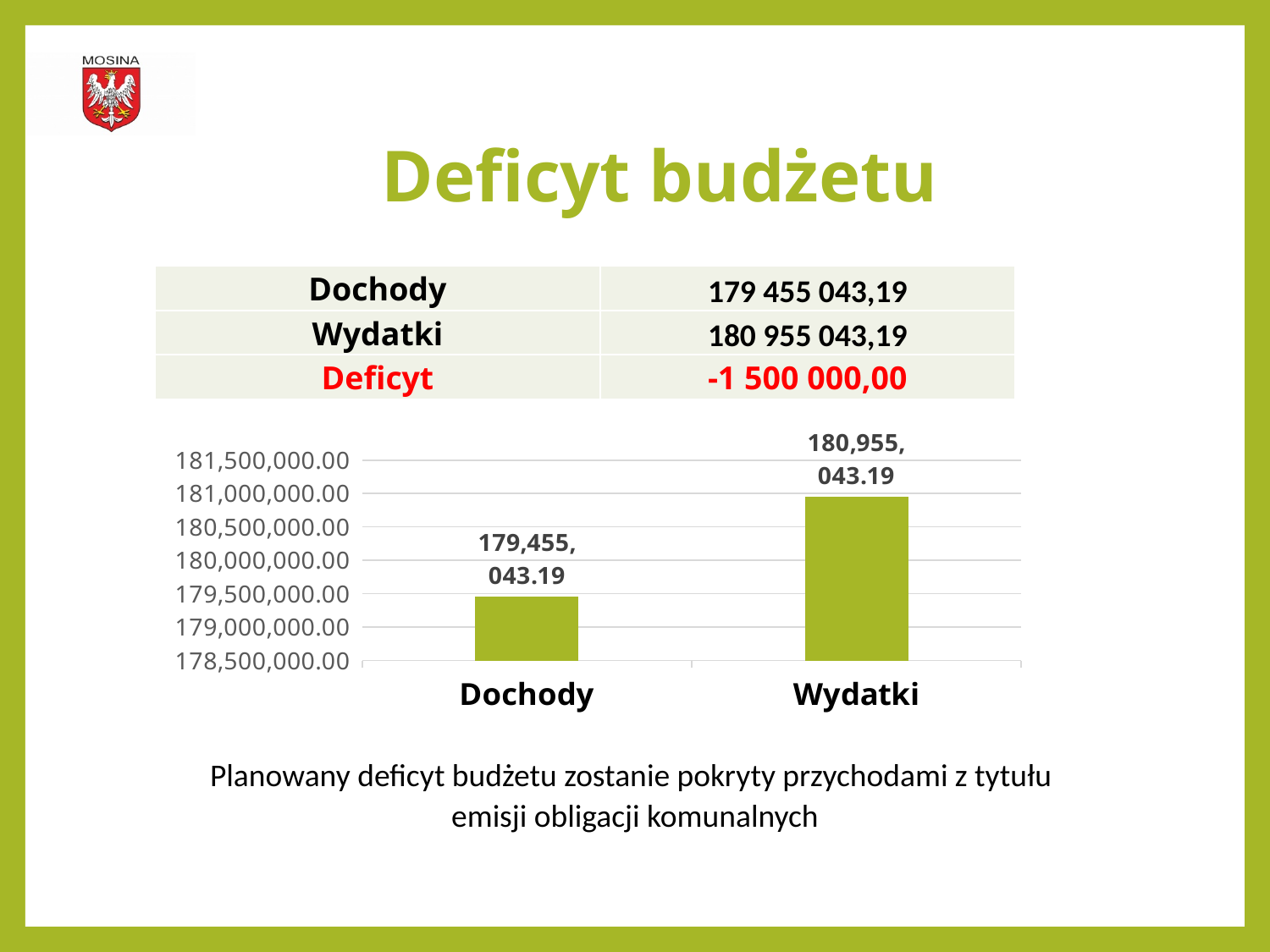
Which category has the lower bar in the chart? Dochody What type of chart is shown on the slide? bar chart How many categories are shown on the x axis of the chart? 2 Do the bar values rise or fall from Dochody to Wydatki? rise What is the value of the Wydatki bar in the chart? 180,955,043.19 What is the difference between the Wydatki and Dochody values in the chart? 1,500,000.00 Which category has the higher bar in the chart? Wydatki What is the value of the Dochody bar in the chart? 179,455,043.19 Is the value for Dochody greater or less than 180,000,000.00? less Is the value for Dochody larger or smaller than the value for Wydatki? smaller What colour are the bars in the chart? green Is the value for Wydatki greater or less than 180,500,000.00? greater